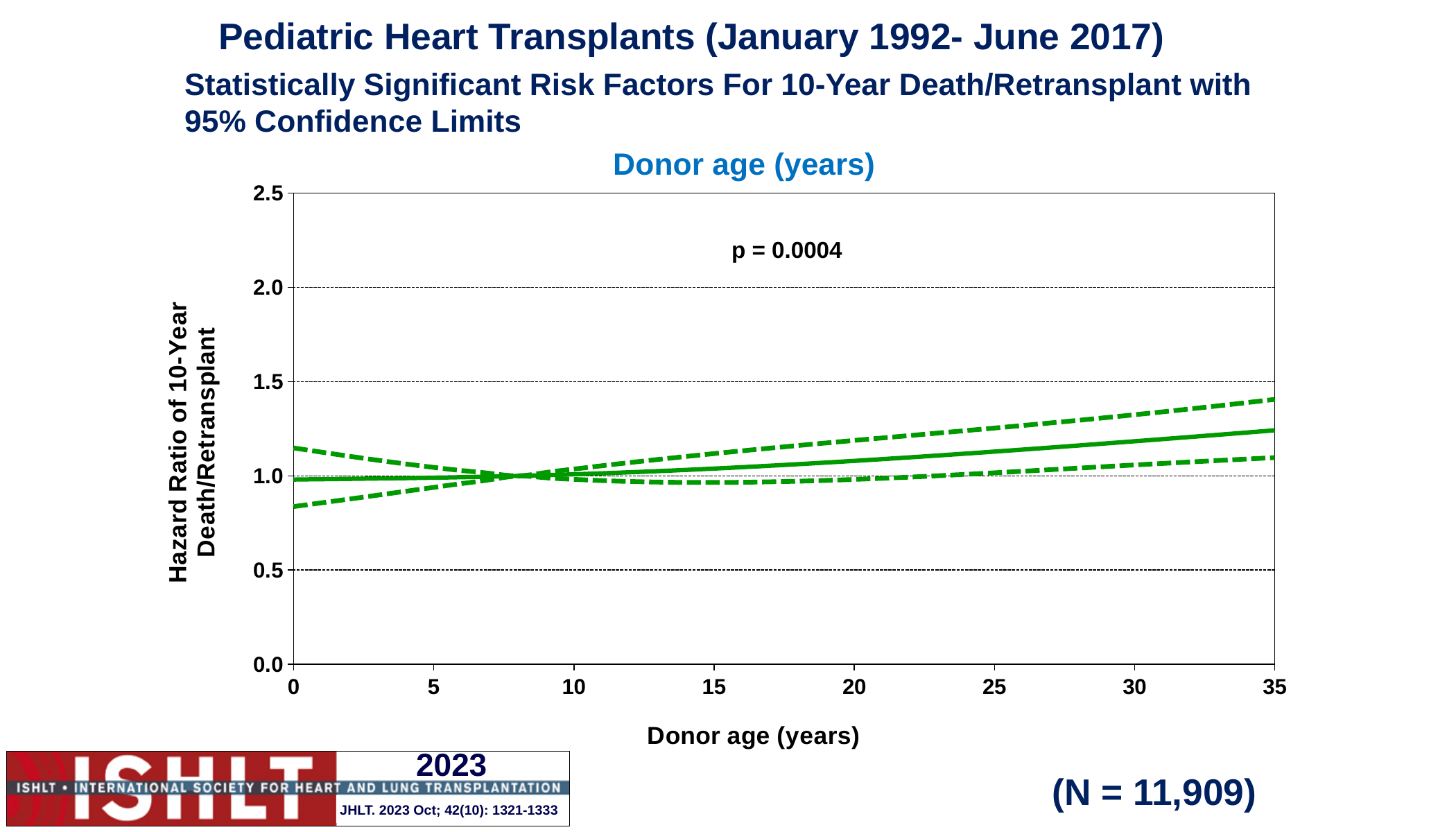
Is the value of the solid hazard ratio line at donor age 35 greater or less than 1.5? less Is the value of the upper dashed confidence limit at donor age 0 greater or less than 1.0? greater Is the value of the upper dashed confidence limit at donor age 35 greater or less than 1.5? less What p-value is printed on the chart? p = 0.0004 Does the solid hazard ratio line rise or fall as donor age increases from 10 to 35 years? rise What is the highest value shown on the y axis? 2.5 What kind of chart is shown on the slide? line chart What is the highest donor age shown on the x axis? 35 How many lines are plotted on the chart? 3